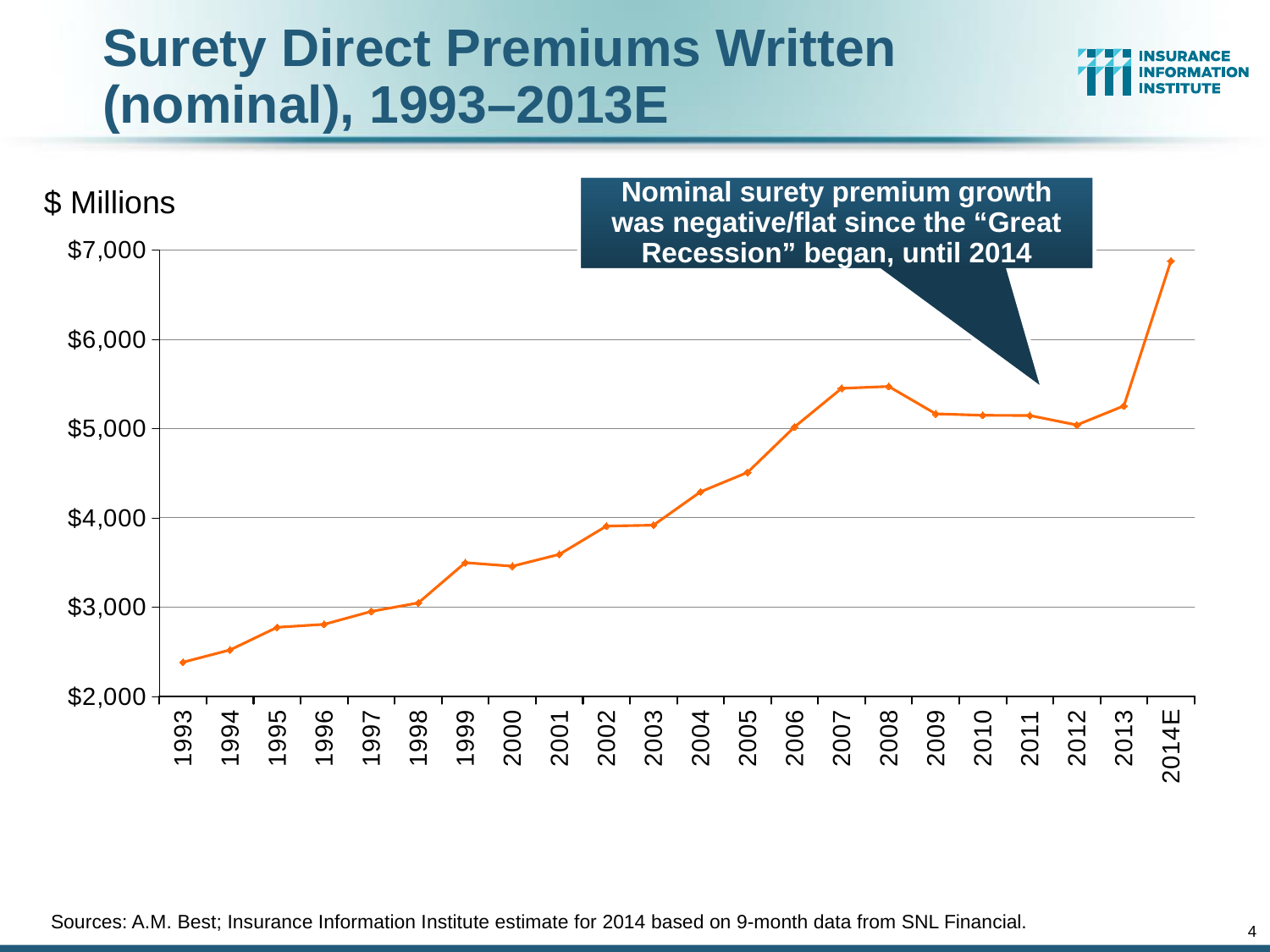
Which year has the larger value, 2013 or 2014E? 2014E How many years (data points) are plotted on the chart? 22 Is the value for 2004 greater or less than $4,000? greater Is the value for 2014E greater or less than $6,000? greater Which year has the lowest surety direct premiums written? 1993 Which year has the larger value, 2008 or 2012? 2008 Do the values generally rise or fall from 1993 to 2008? rise What unit is shown for the y axis of the chart? $ Millions What kind of chart is shown on the slide? line chart Which year has the highest surety direct premiums written? 2014E Is the value for 1993 greater or less than $3,000? less